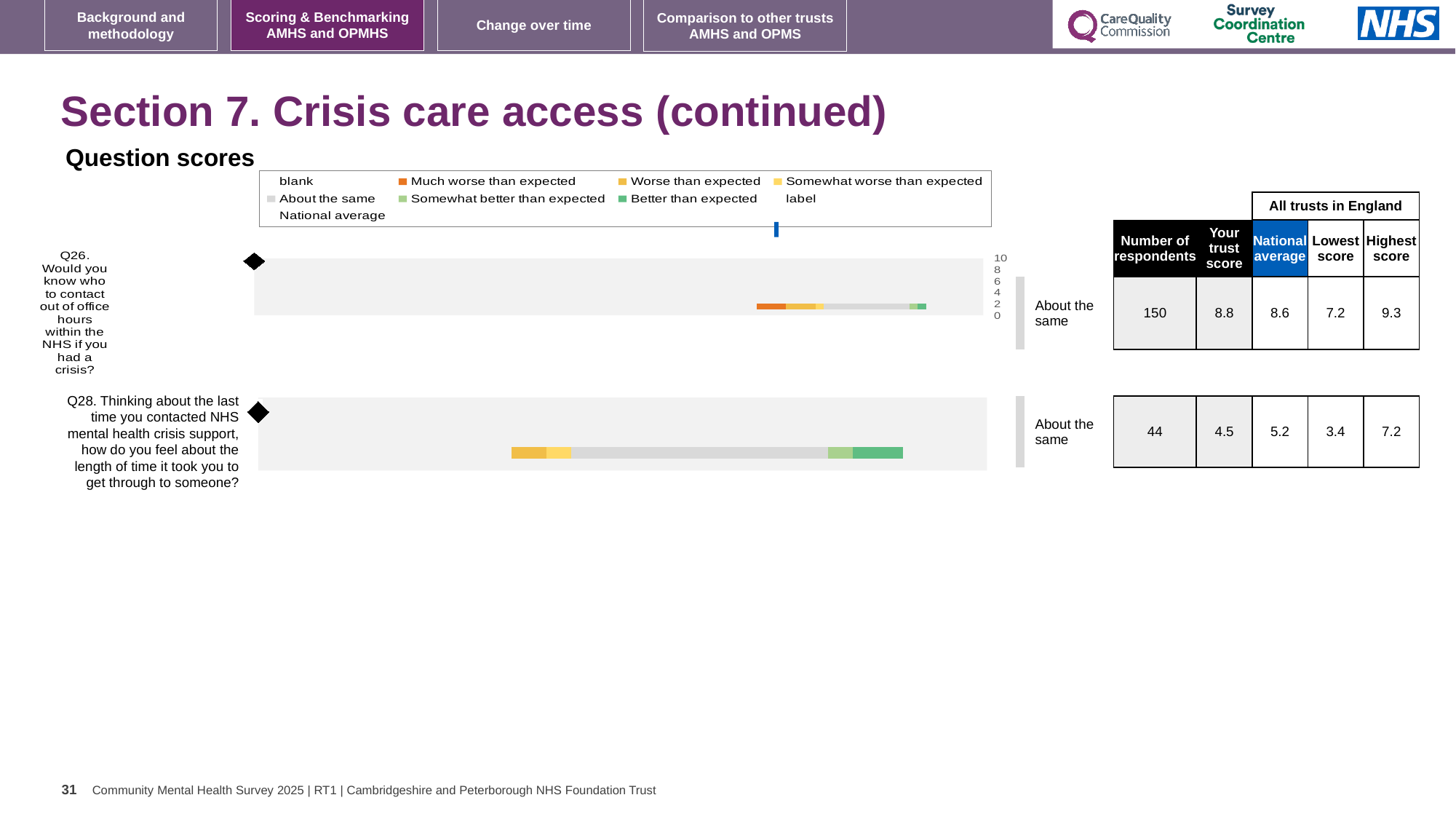
What kind of chart is used to show the question scores on this slide? bar chart How many questions are plotted in the question scores chart? 2 What is the trust's score for Q26 (Would you know who to contact out of office hours within the NHS if you had a crisis?)? 8.8 What rating category is shown for Q26 in the question scores chart? About the same What is the national average score for Q26? 8.6 What is the highest score among all trusts in England for Q26? 9.3 Which question has the higher trust score, Q26 or Q28? Q26 How many respondents answered Q28 (how do you feel about the length of time it took you to get through to someone)? 44 What is the trust's score for Q28? 4.5 What is the difference between the highest and lowest scores across all trusts in England for Q28? 3.8 What is the difference between the national average and the trust's score for Q28? 0.7 What is the lowest score among all trusts in England for Q28? 3.4